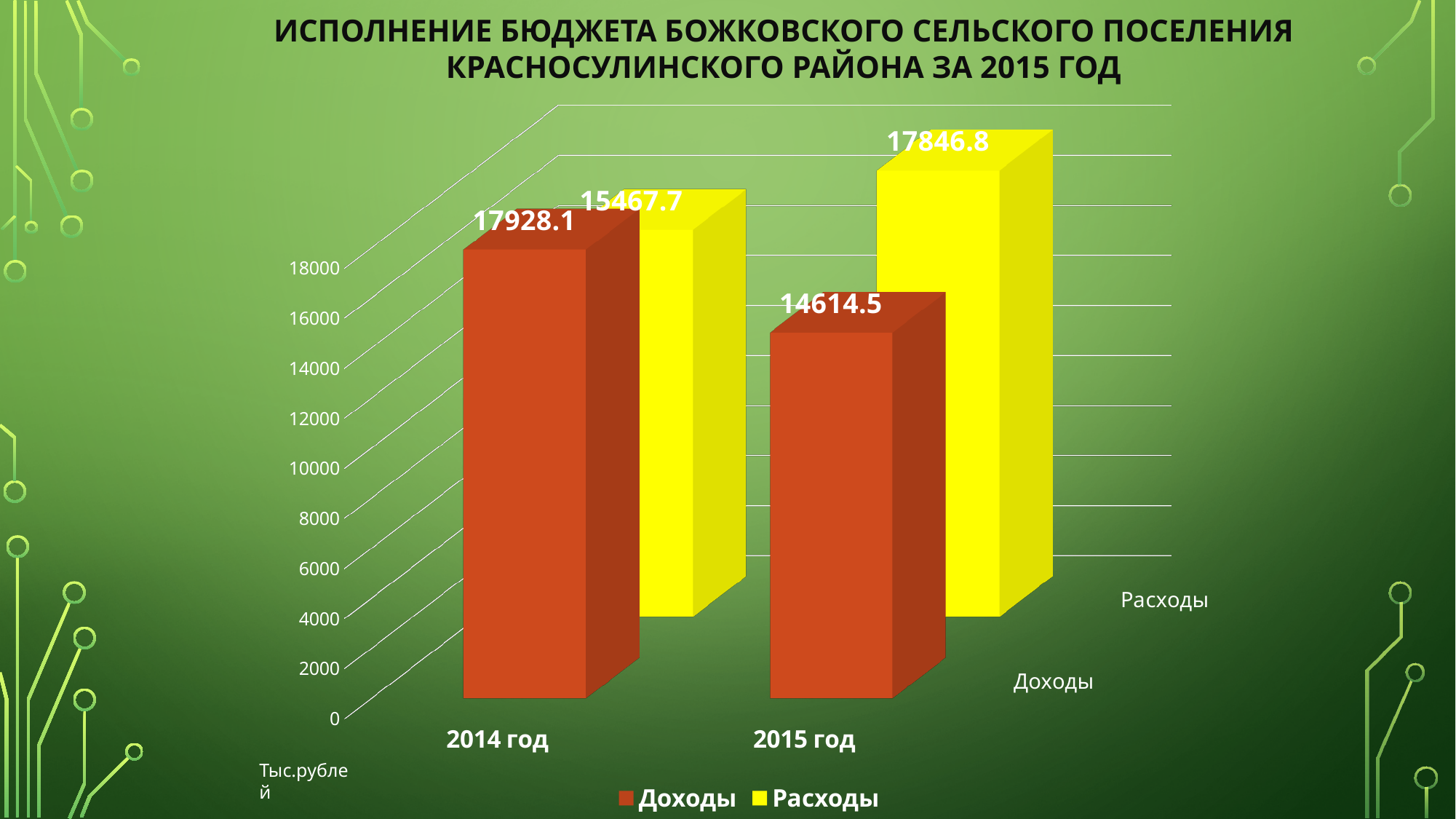
What colour represents Расходы in the chart? Yellow What is the value of Доходы for 2015 год? 14614.5 Which year has the lower value of Расходы? 2014 год What is the value of Расходы for 2015 год? 17846.8 What is the difference between Доходы and Расходы in 2014 год? 2460.4 In 2015 год, which is larger: Доходы or Расходы? Расходы By how much did Доходы decrease from 2014 год to 2015 год? 3313.6 How many series does the legend list? 2 Which year has the higher value of Доходы? 2014 год What is the value of Расходы for 2014 год? 15467.7 What type of chart is shown on the slide? Bar chart What is the value of Доходы for 2014 год? 17928.1